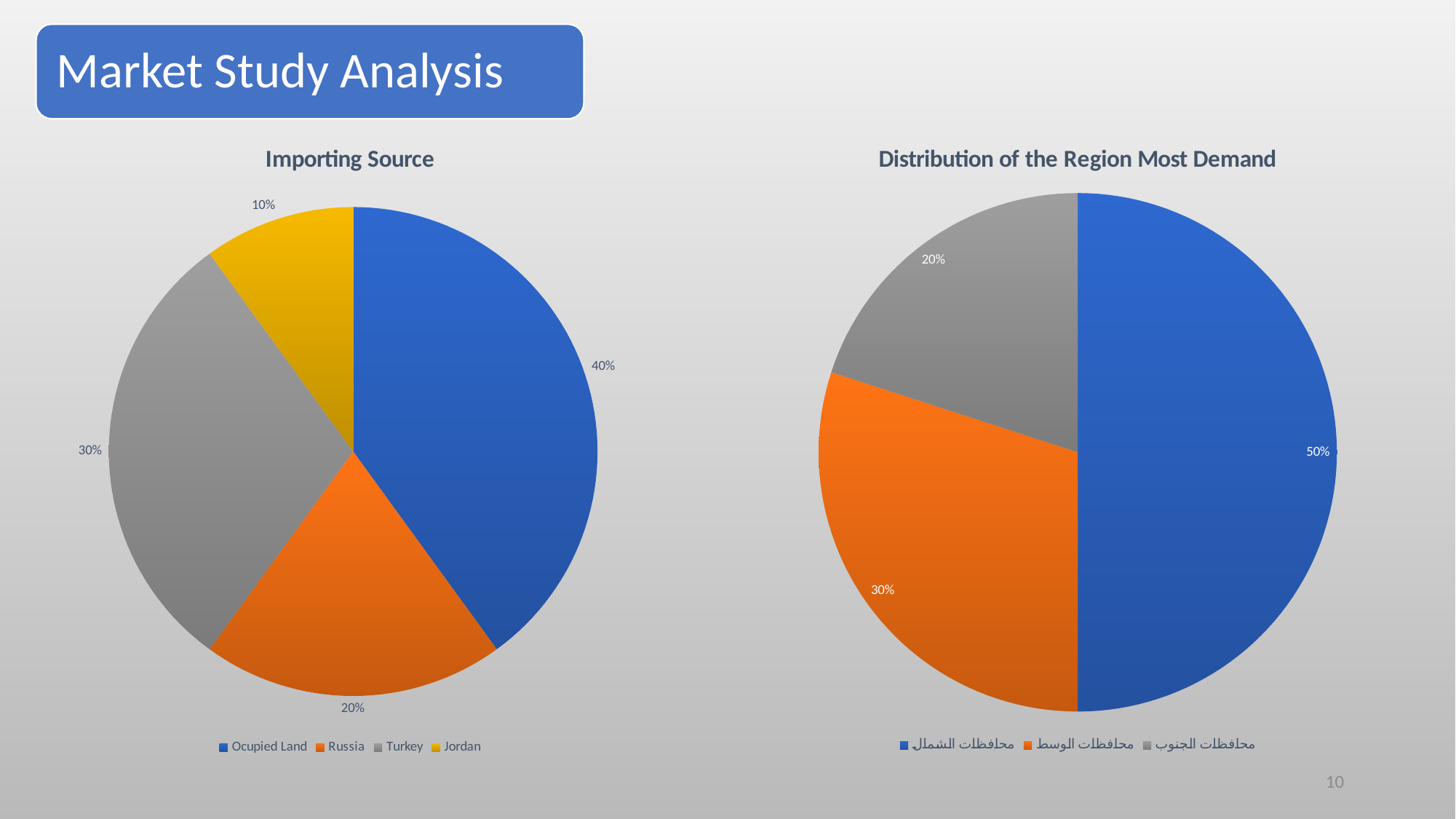
In the Distribution of the Region Most Demand chart, what is the difference between the shares of محافظات الشمال and محافظات الوسط? 20% In the Importing Source chart, what share does Jordan have? 10% How many categories does the legend of the Distribution of the Region Most Demand chart list? 3 What type of chart is the Importing Source chart? Pie chart How many slices does the Importing Source chart have? 4 In the Importing Source chart, which source has the largest share? Ocupied Land In the Importing Source chart, what share does Ocupied Land have? 40% In the Importing Source chart, which source has the smallest share? Jordan In the Distribution of the Region Most Demand chart, what share does محافظات الشمال have? 50% In the Distribution of the Region Most Demand chart, which region has the smallest share? محافظات الجنوب In the Importing Source chart, which has a larger share, Turkey or Russia? Turkey In the Importing Source chart, what is the difference between the shares of Turkey and Russia? 10%